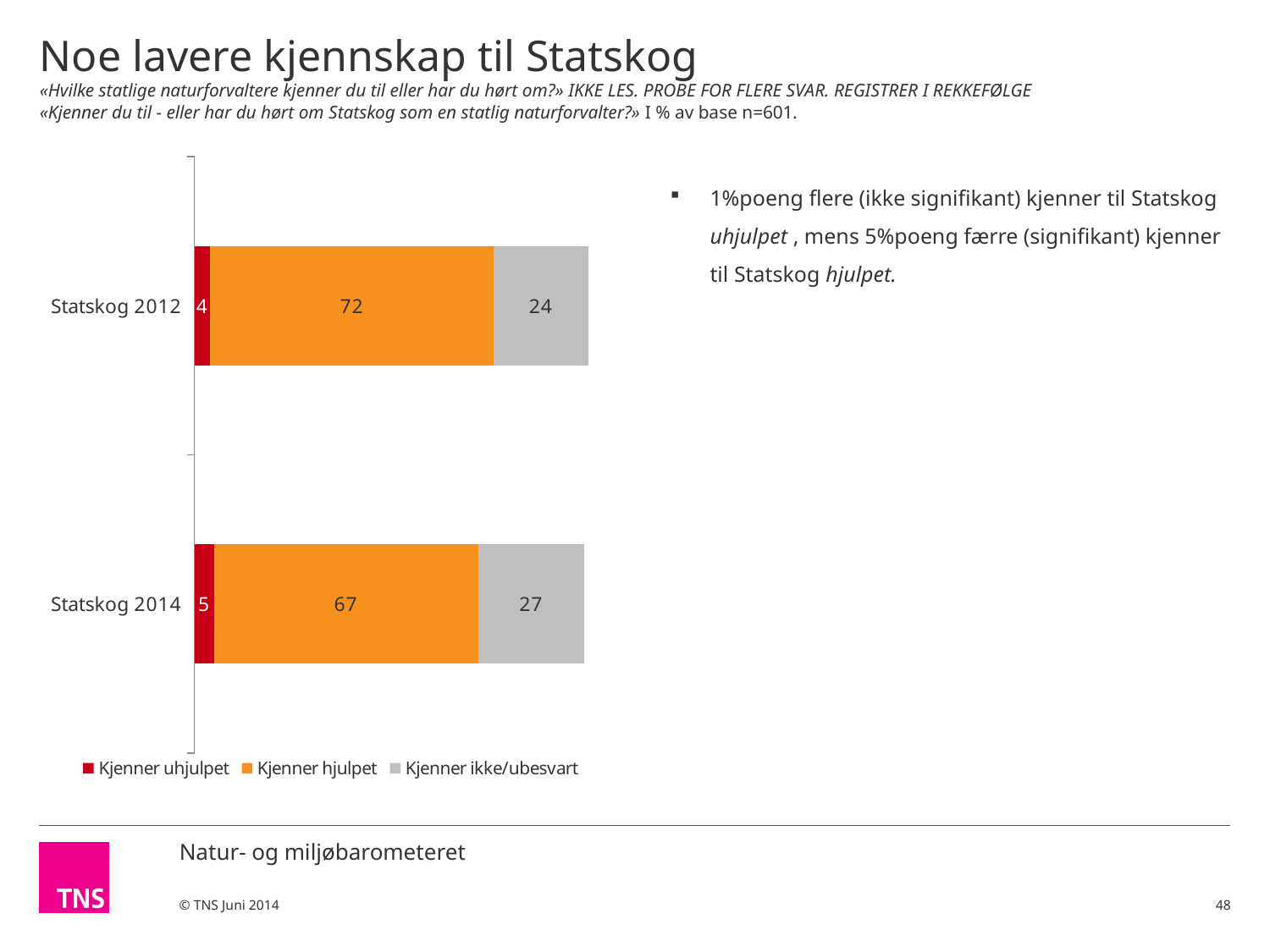
What is the difference between the "Kjenner hjulpet" values for Statskog 2012 and Statskog 2014? 5 What is the value for "Kjenner hjulpet" for Statskog 2012? 72 What is the value for "Kjenner ikke/ubesvart" for Statskog 2014? 27 How many series does the legend list? 3 What is the total of the stacked bar for Statskog 2012? 100 What is the total of the stacked bar for Statskog 2014? 99 Which category has the higher value for "Kjenner hjulpet", Statskog 2012 or Statskog 2014? Statskog 2012 What is the value for "Kjenner uhjulpet" for Statskog 2014? 5 What kind of chart is shown on the slide? Stacked bar chart What is the value for "Kjenner ikke/ubesvart" for Statskog 2012? 24 How many categories are shown on the chart? 2 What is the difference between the "Kjenner ikke/ubesvart" values for Statskog 2014 and Statskog 2012? 3